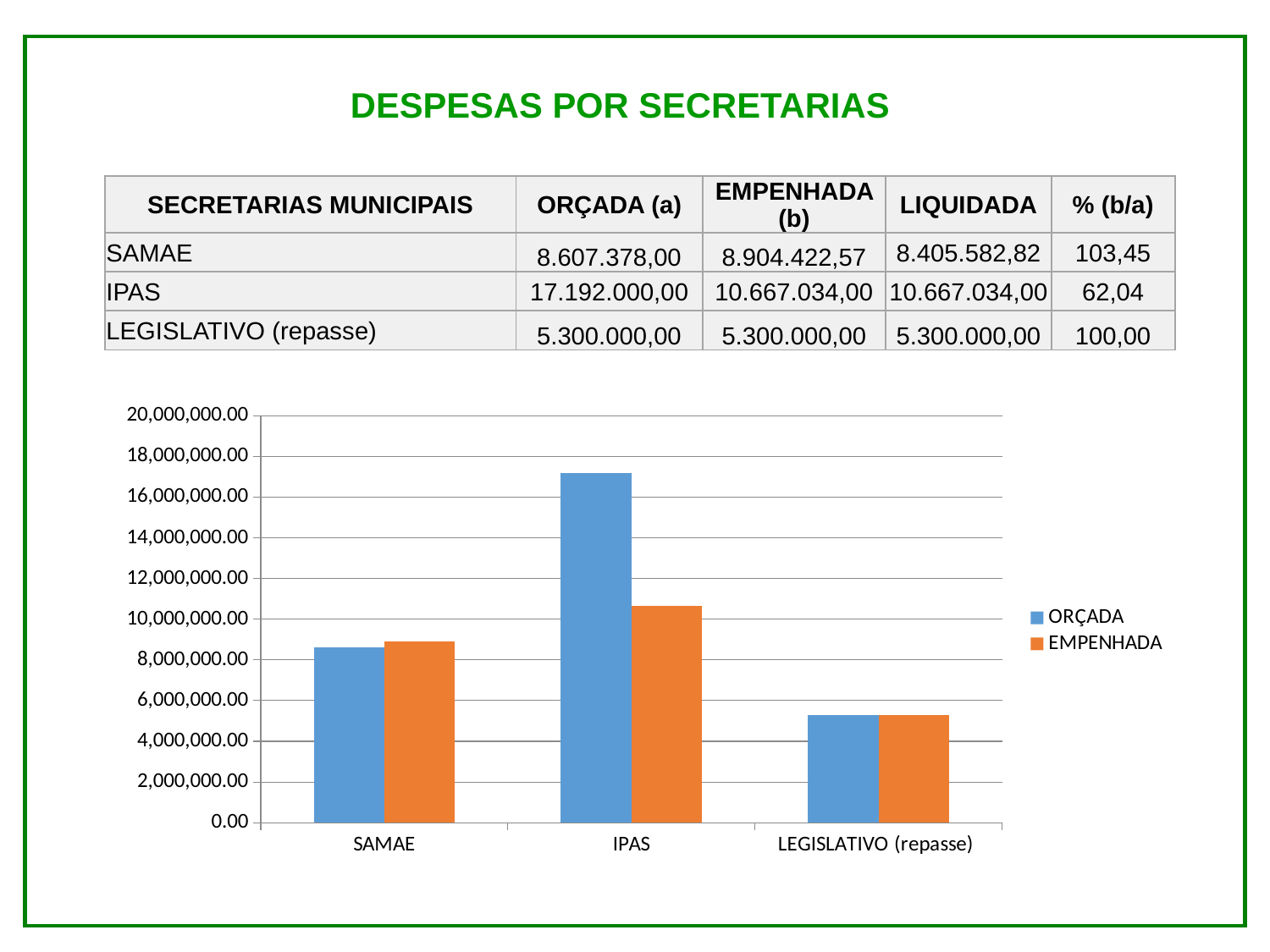
Which colour represents the ORÇADA series in the chart? blue What kind of chart is shown on the slide? bar chart Is the ORÇADA value for IPAS greater or less than 16,000,000.00? greater How many series does the chart legend list? 2 Which category has the lowest ORÇADA bar? LEGISLATIVO (repasse) For IPAS, which is larger, the ORÇADA bar or the EMPENHADA bar? ORÇADA How many categories are shown on the x axis of the chart? 3 Which category has the highest ORÇADA bar? IPAS Which category has the lowest EMPENHADA bar? LEGISLATIVO (repasse) Is the ORÇADA value for SAMAE greater or less than 10,000,000.00? less Which category has the highest EMPENHADA bar? IPAS Is the EMPENHADA value for IPAS greater or less than 12,000,000.00? less